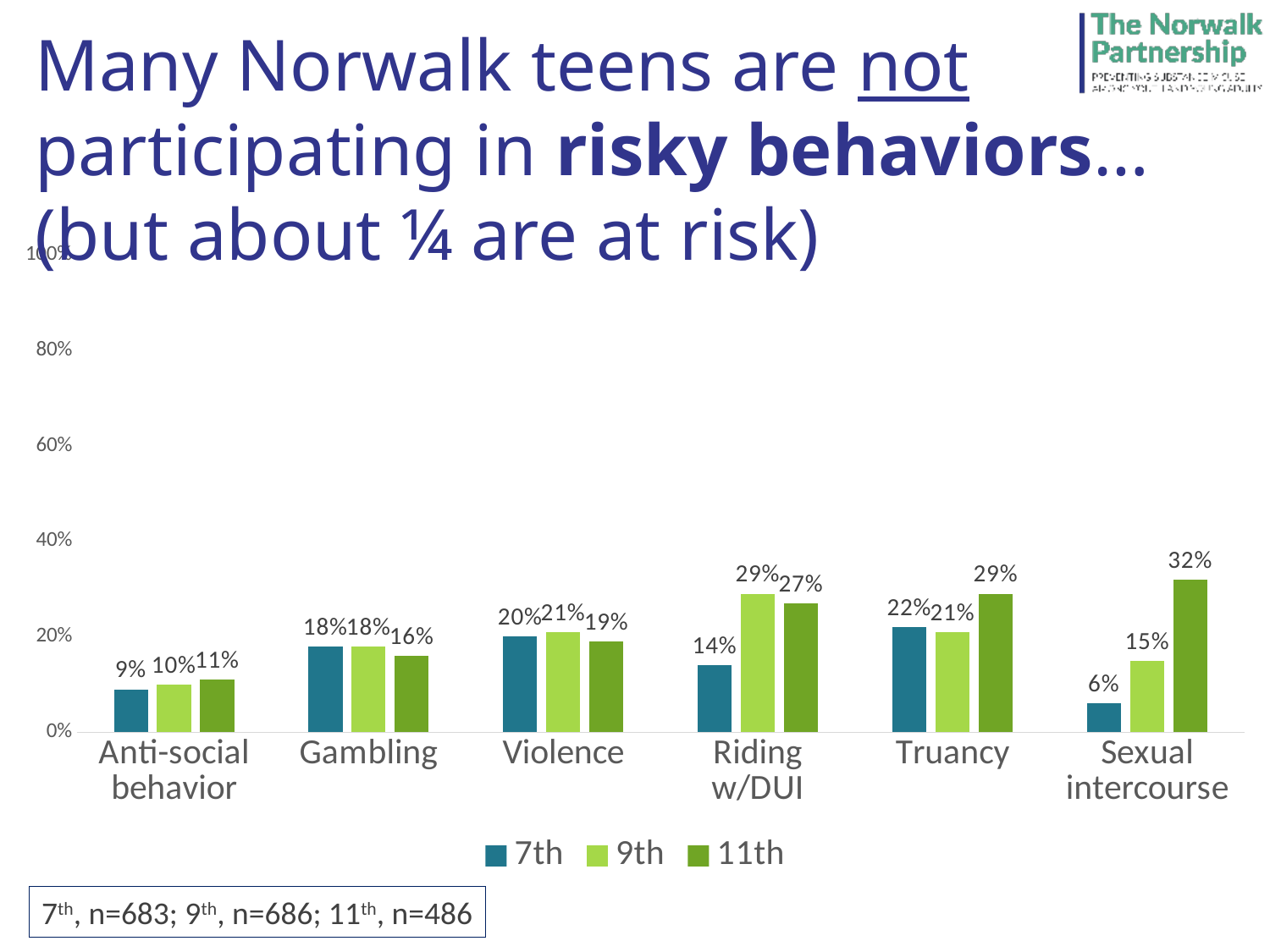
How many series does the legend list? 3 Which category has the lowest value for 11th grade? Anti-social behavior How many categories are shown on the x axis? 6 Which is larger for Riding w/DUI: the 7th grade value or the 9th grade value? 9th grade What is the difference between the 11th grade and 7th grade values for Sexual intercourse? 26% Which category has the highest value for 7th grade? Truancy What is the value for 11th grade in the Sexual intercourse category? 32% What is the value for 9th grade in the Truancy category? 21% What are the three series listed in the legend? 7th, 9th, 11th What is the value for 7th grade in the Riding w/DUI category? 14% What kind of chart is shown on the slide? Bar chart Do the values for 11th grade rise or fall from Truancy to Sexual intercourse? Rise